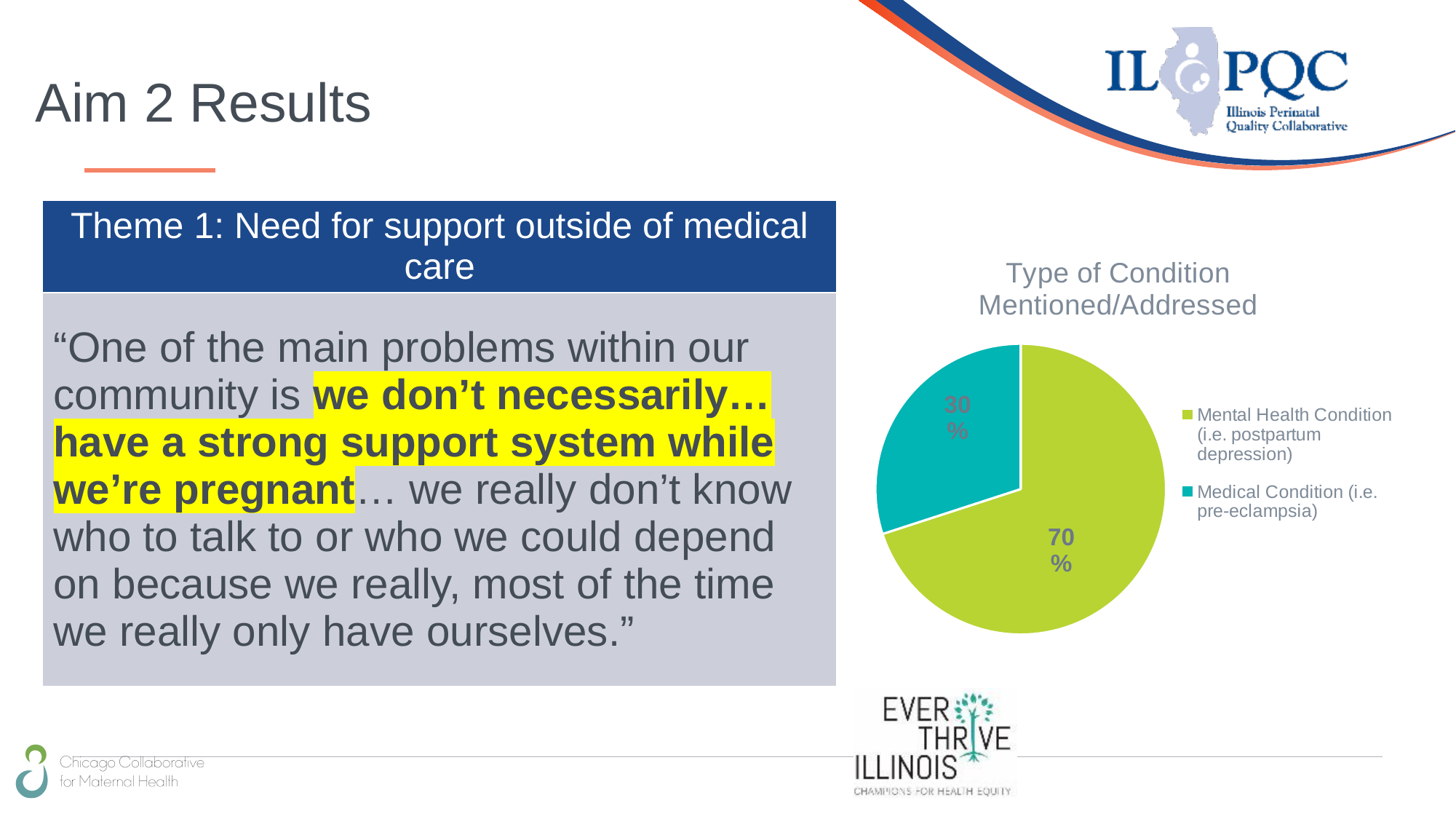
Which category has the largest slice of the pie? Mental Health Condition (i.e. postpartum depression) What is the difference in percentage points between the Mental Health Condition slice and the Medical Condition slice? 40 What type of chart is shown on the slide? pie chart What share of the pie is Mental Health Condition (i.e. postpartum depression)? 70% Which is larger: the Mental Health Condition slice or the Medical Condition slice? Mental Health Condition How many entries does the chart legend list? 2 What colour is the Medical Condition (i.e. pre-eclampsia) slice? teal What share of the pie is Medical Condition (i.e. pre-eclampsia)? 30% What is the title of the chart? Type of Condition Mentioned/Addressed How many categories does the pie chart show? 2 Which category has the smallest slice of the pie? Medical Condition (i.e. pre-eclampsia)